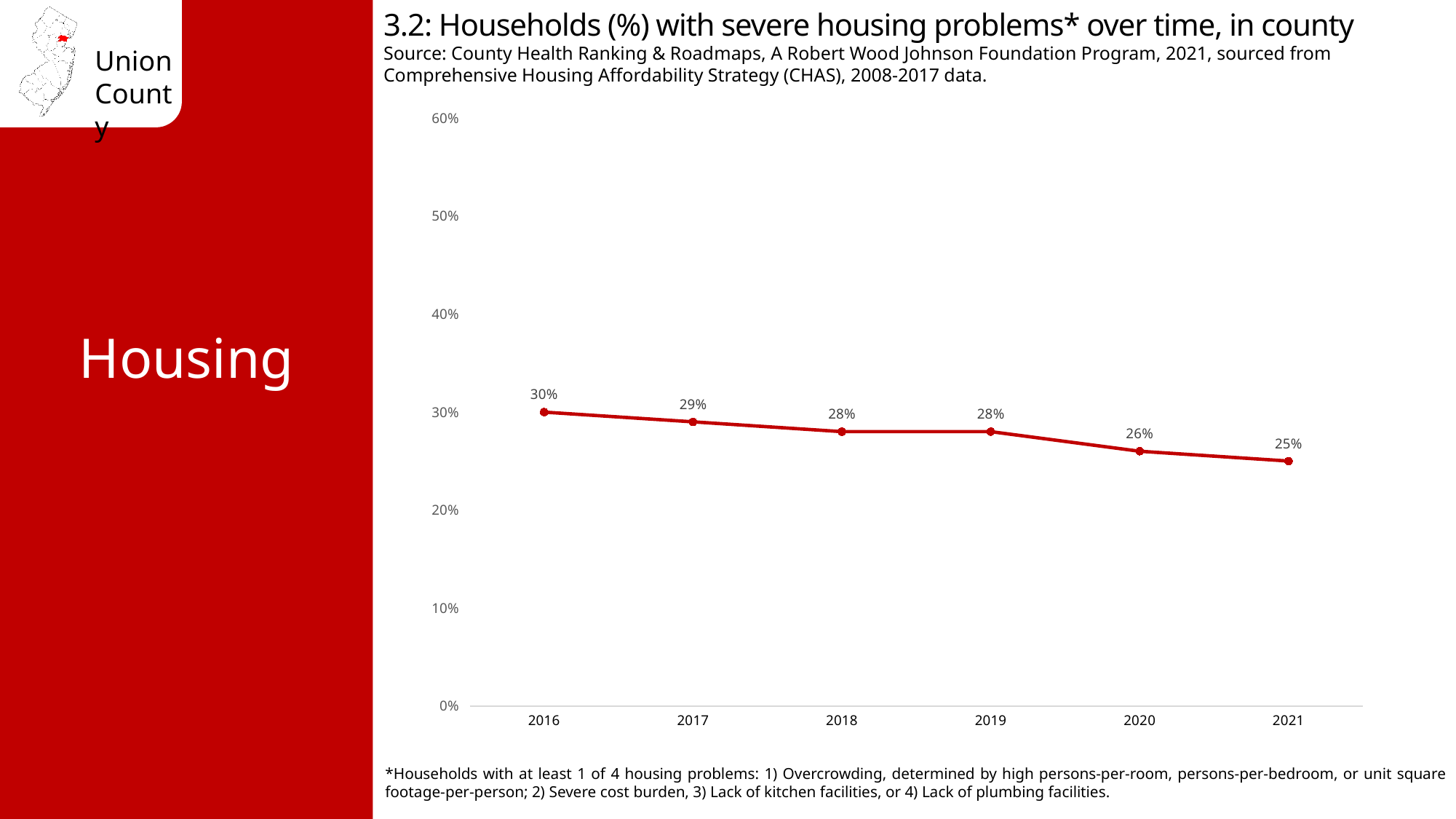
What kind of chart is shown on the slide? line chart What is the difference in percentage points between 2016 and 2021? 5 What is the value shown for 2021? 25% Do the values rise or fall from 2016 to 2021? fall What is the title of the chart? 3.2: Households (%) with severe housing problems* over time, in county Which year has a higher value, 2017 or 2020? 2017 Which year has the highest percentage of households with severe housing problems? 2016 Which year has the lowest percentage of households with severe housing problems? 2021 How many years are plotted on the chart? 6 Is the value for 2019 greater or less than 30%? less What is the value shown for 2020? 26% What percentage of households had severe housing problems in 2016? 30%